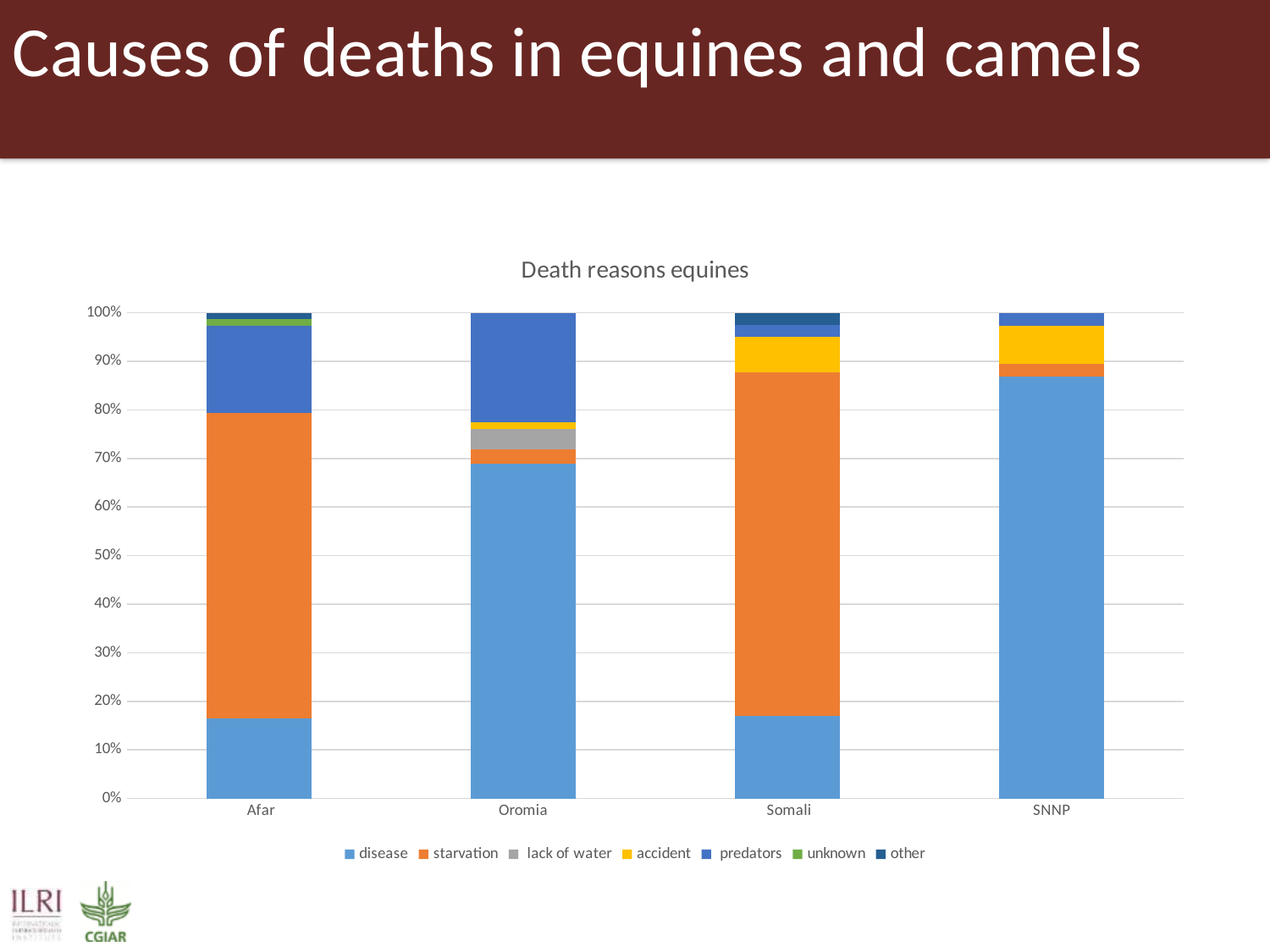
Which region has the largest share of equine deaths attributed to starvation? Somali Which region has a larger share of deaths from starvation, Afar or SNNP? Afar Which region has the largest share of equine deaths attributed to disease? SNNP Is the share of deaths from disease in SNNP greater or less than 80%? greater How many series does the legend list? 7 Is the share of deaths from disease in Afar greater or less than 20%? less Which region has a larger share of deaths from disease, Oromia or Afar? Oromia What kind of chart is shown on the slide? stacked bar chart How many regions are shown on the x axis of the chart? 4 Is the share of deaths from disease in Oromia greater or less than 60%? greater Which region is the only one showing a 'lack of water' segment? Oromia What is the title of the chart? Death reasons equines